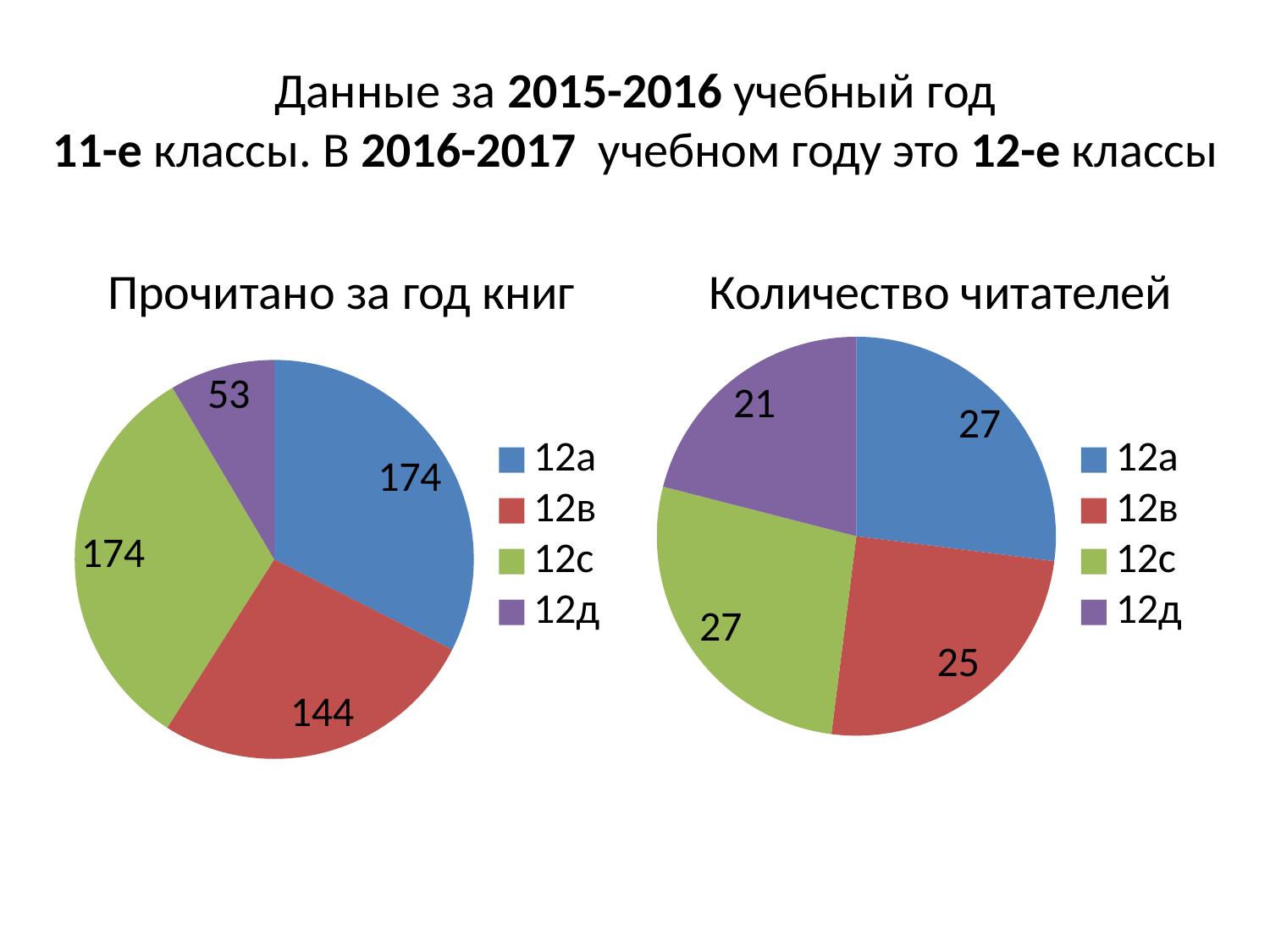
In the chart titled "Прочитано за год книг", what is the value for 12д? 53 In the chart titled "Прочитано за год книг", what is the value for 12в? 144 In the chart titled "Количество читателей", what share of the total does 12д represent? 21% In the chart titled "Количество читателей", what is the value for 12в? 25 In the chart titled "Прочитано за год книг", which is larger, the value for 12в or the value for 12д? 12в In the chart titled "Количество читателей", what is the value for 12д? 21 In the chart titled "Прочитано за год книг", what is the difference between the values for 12а and 12в? 30 In the chart titled "Количество читателей", which category has the smallest slice? 12д In the chart titled "Прочитано за год книг", which category has the smallest slice? 12д What type of chart is the chart titled "Количество читателей"? Pie chart In the chart titled "Количество читателей", what is the difference between the values for 12с and 12д? 6 How many entries does the legend of the chart titled "Прочитано за год книг" list? 4